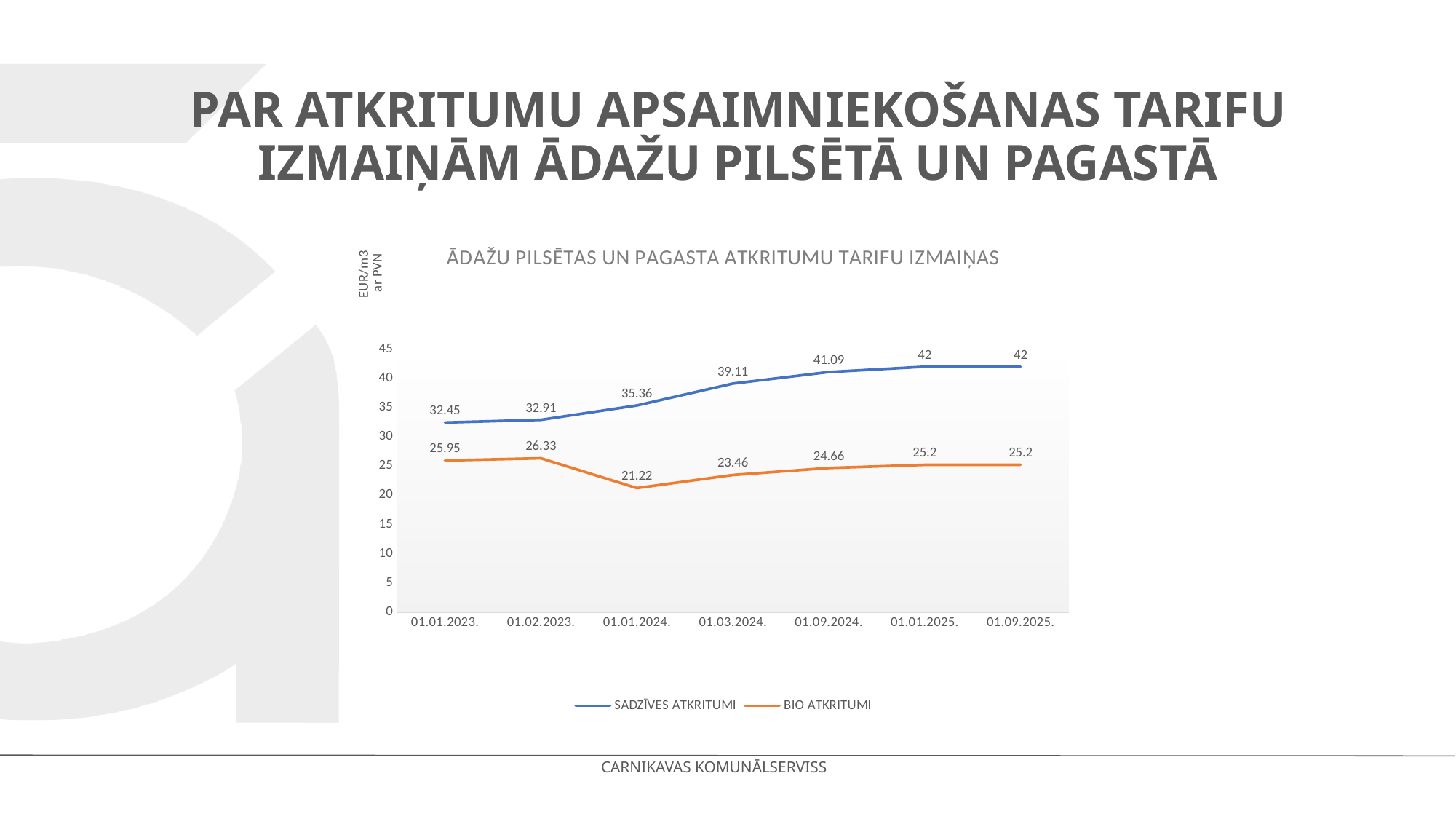
What is the highest value shown for SADZĪVES ATKRITUMI? 42 What is the value for SADZĪVES ATKRITUMI on 01.01.2024.? 35.36 How many dates are shown on the x axis? 7 Which series has the larger value on 01.09.2024., SADZĪVES ATKRITUMI or BIO ATKRITUMI? SADZĪVES ATKRITUMI What is the difference between the SADZĪVES ATKRITUMI and BIO ATKRITUMI values on 01.01.2023.? 6.5 On which date is the BIO ATKRITUMI value lowest? 01.01.2024. What is the value for SADZĪVES ATKRITUMI on 01.09.2025.? 42 Does the SADZĪVES ATKRITUMI series rise or fall from 01.01.2023. to 01.01.2025.? rise Is the value for BIO ATKRITUMI on 01.02.2023. greater or less than 25? greater What is the value for BIO ATKRITUMI on 01.03.2024.? 23.46 How many series does the legend list? 2 What kind of chart is shown on the slide? line chart